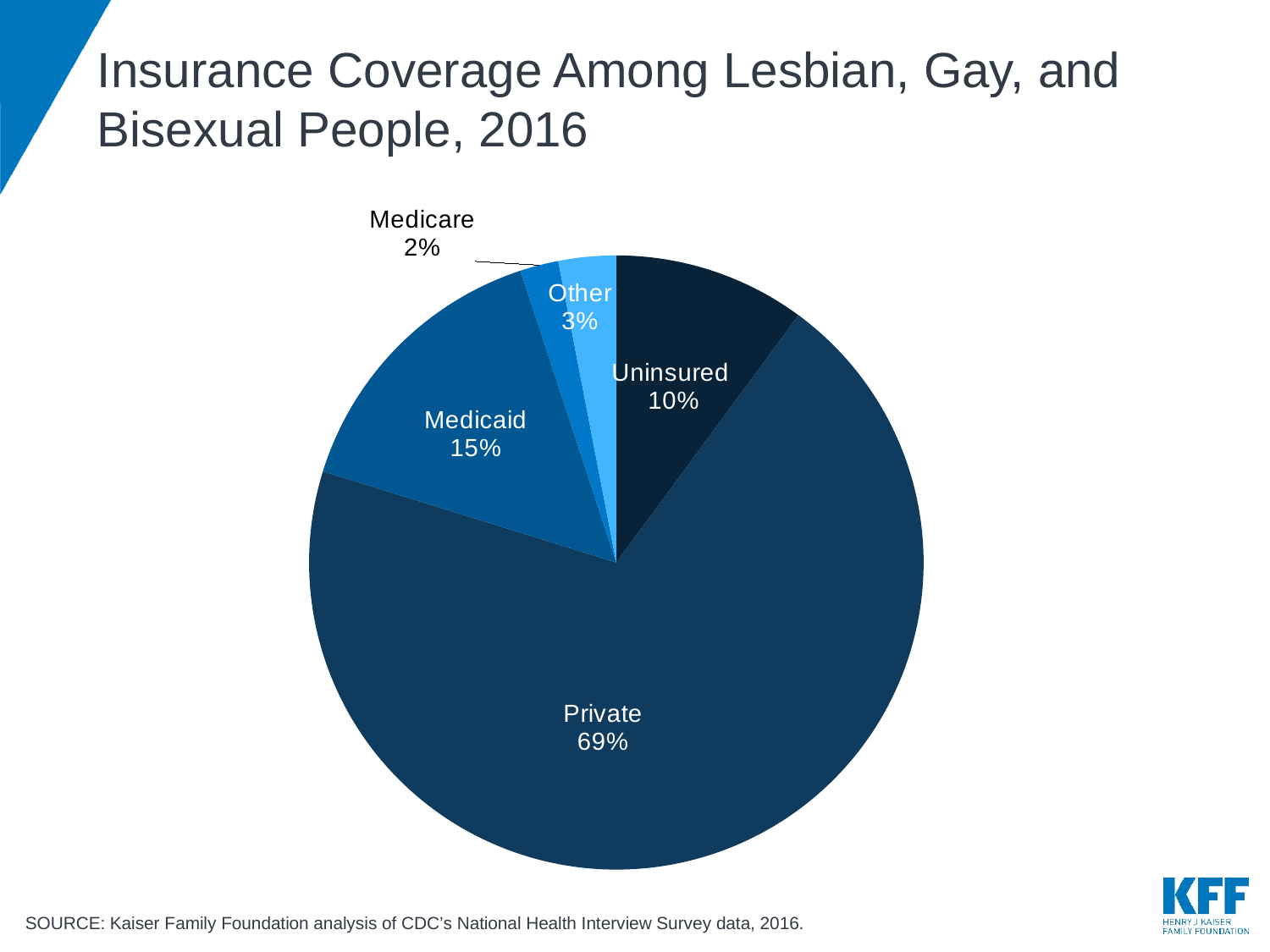
What type of chart is shown on the slide? pie chart What is the value for Medicare? 2% How many slices does the pie chart have? 5 What is the value for Uninsured? 10% Which is larger, Other or Medicare? Other What is the title of the chart? Insurance Coverage Among Lesbian, Gay, and Bisexual People, 2016 What is the value for Medicaid? 15% What share of the pie is Private? 69% Which category has the smallest share? Medicare What is the difference between the Medicaid and Uninsured shares? 5% What is the value for Other? 3% Which category has the largest share? Private